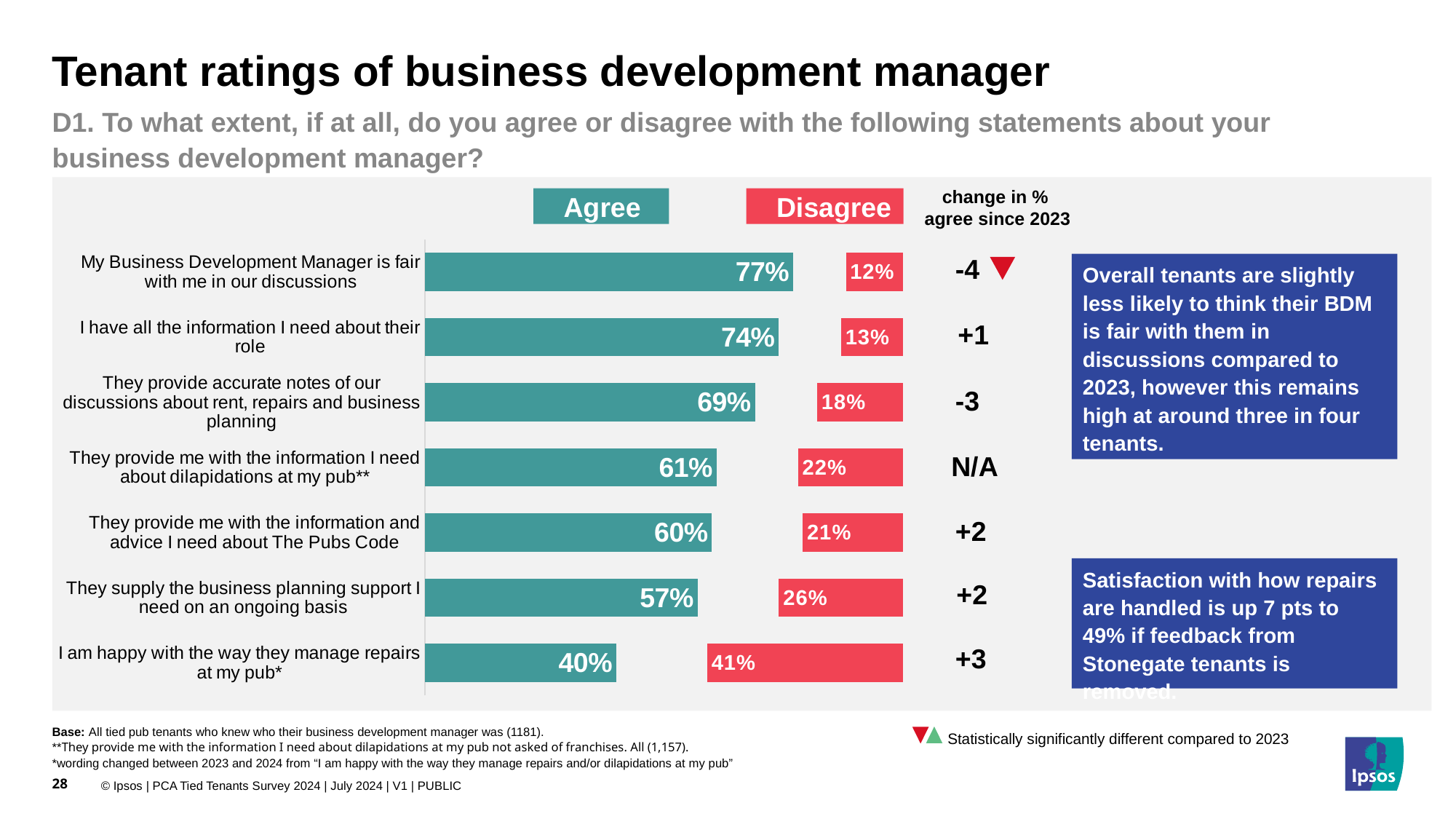
How many statements are shown in the chart? 7 Which statement has the lowest Agree percentage? I am happy with the way they manage repairs at my pub What is the change in % agree since 2023 for 'My Business Development Manager is fair with me in our discussions'? -4 What is the Agree percentage for 'They provide me with the information and advice I need about The Pubs Code'? 60% How many series does the chart legend list? 2 What percentage of tenants disagree with the statement 'I am happy with the way they manage repairs at my pub'? 41% What percentage of tenants agree that their Business Development Manager is fair with them in their discussions? 77% Which statement has the highest Agree percentage? My Business Development Manager is fair with me in our discussions What colour are the Disagree bars in the chart? Red What kind of chart is shown on the slide? Bar chart Which is larger: the Disagree percentage for 'They provide accurate notes of our discussions about rent, repairs and business planning' or the Disagree percentage for 'I have all the information I need about their role'? They provide accurate notes of our discussions about rent, repairs and business planning What is the difference between the Agree and Disagree percentages for 'They supply the business planning support I need on an ongoing basis'? 31 percentage points